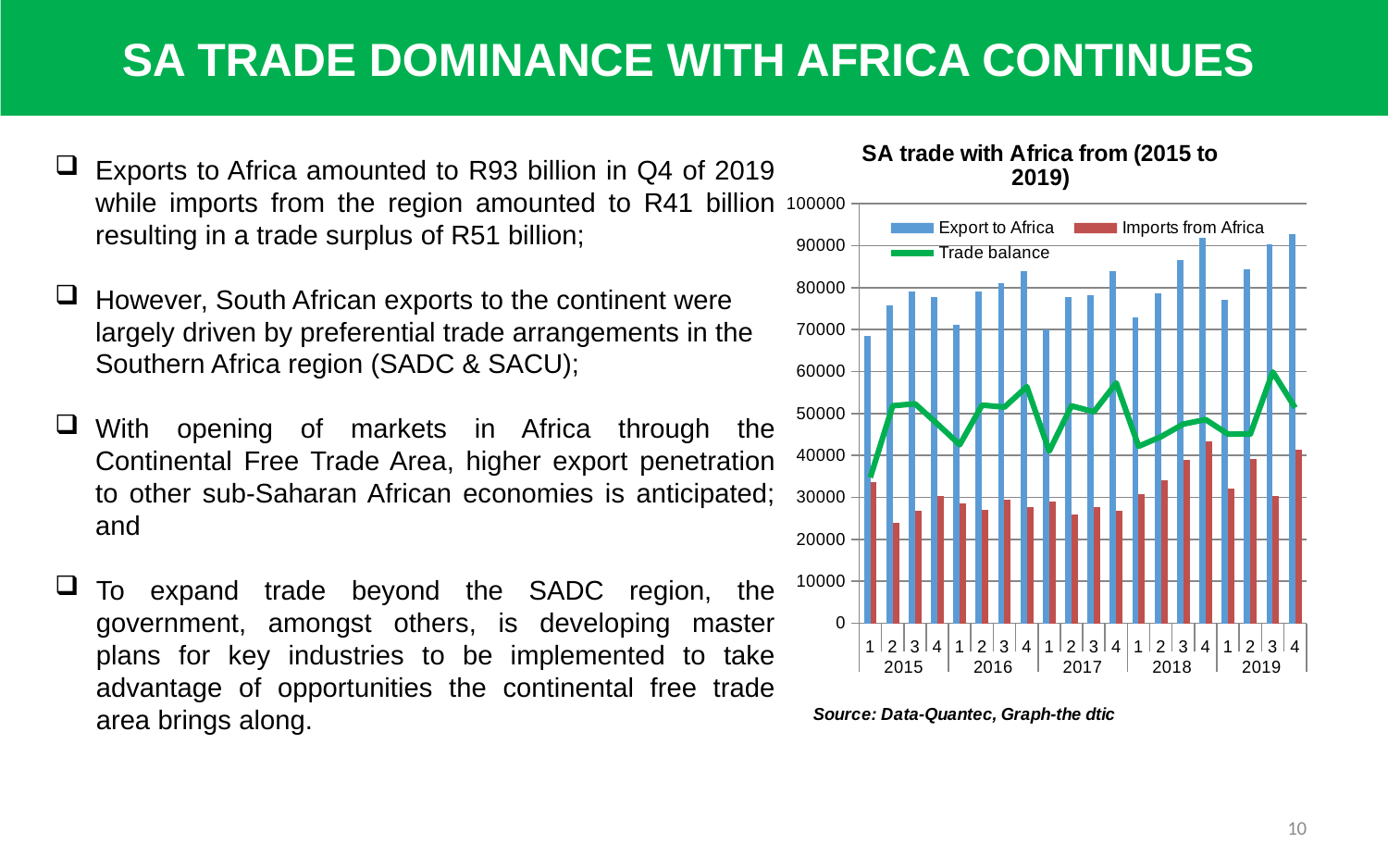
How many series does the legend of the chart list? 3 In which quarter is the Trade balance line at its highest point? Q3 2019 How many quarterly periods are plotted along the x axis of the chart? 20 Is the value of Imports from Africa in Q2 2015 greater or less than 30000? less In which quarter is the Trade balance line at its lowest point? Q1 2015 What kind of chart is shown on the slide? A combined bar and line chart In which quarter is the Imports from Africa bar the lowest? Q2 2015 In Q4 2019, which is larger: Export to Africa or Imports from Africa? Export to Africa Which series in the chart is drawn as a green line? Trade balance What is the title of the chart? SA trade with Africa from (2015 to 2019) Is the value of Export to Africa in Q4 2019 greater or less than 90000? greater How many years does the x axis of the chart cover? 5